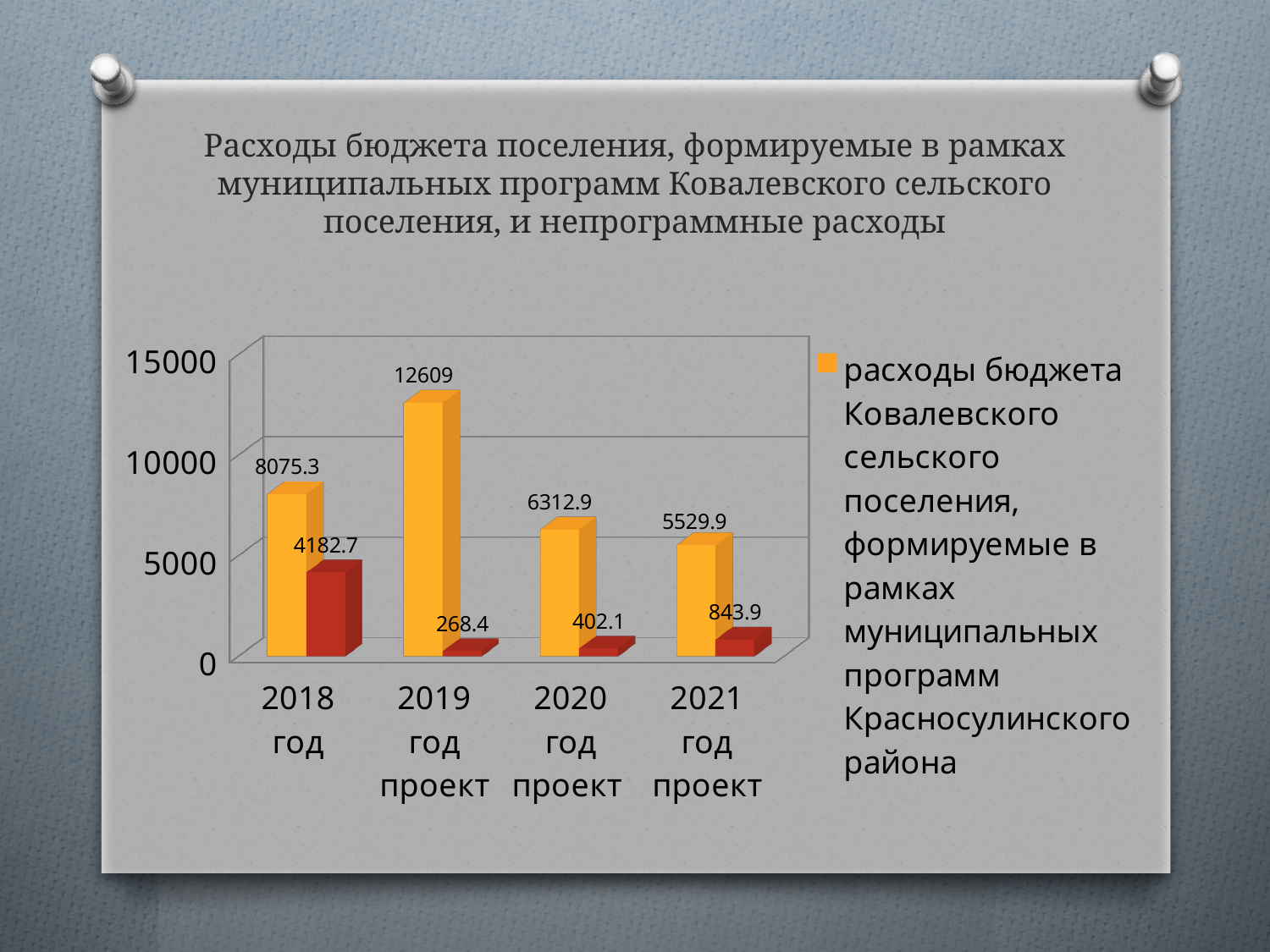
What kind of chart is shown on the slide? bar chart Do the orange bar values rise or fall from 2019 год проект to 2021 год проект? fall What is the total of the orange and red bar values for 2018 год? 12258 What is the value of the orange bar for 2019 год проект? 12609 Which category has the lowest red bar? 2019 год проект What is the difference between the orange bar values for 2018 год and 2021 год проект? 2545.4 Is the orange bar value for 2020 год проект greater or less than 5000? greater Which is larger: the red bar for 2020 год проект or the red bar for 2021 год проект? 2021 год проект Which category has the highest orange bar? 2019 год проект What is the value of the red bar for 2018 год? 4182.7 What colour is the series labelled 'расходы бюджета Ковалевского сельского поселения, формируемые в рамках муниципальных программ Красносулинского района' in the legend? orange How many categories are shown on the x axis? 4